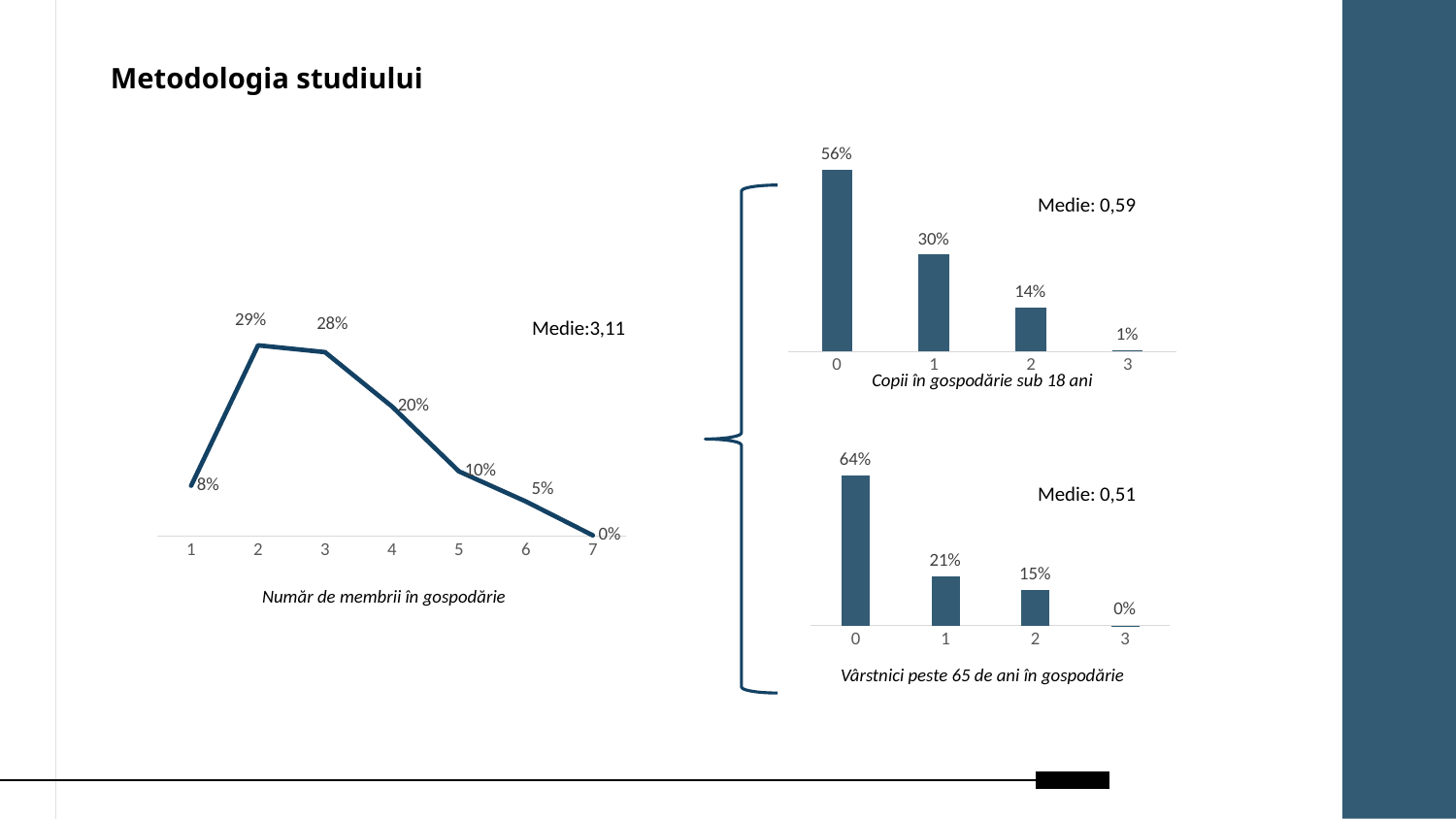
In the chart 'Număr de membrii în gospodărie', what is the value for 5 members? 10% In the chart 'Copii în gospodărie sub 18 ani', which category has the lowest value? 3 In the chart 'Număr de membrii în gospodărie', do the values rise or fall from 3 members to 7 members? Fall In the chart 'Copii în gospodărie sub 18 ani', what is the difference between the values for 1 child and 2 children? 16% In the chart 'Copii în gospodărie sub 18 ani', what is the value for 0 children? 56% In the chart 'Număr de membrii în gospodărie', how many points are plotted on the x axis? 7 In the chart 'Număr de membrii în gospodărie', what is the value for 2 members? 29% What is the mean (Medie) shown for the chart 'Vârstnici peste 65 de ani în gospodărie'? 0,51 What kind of chart is 'Număr de membrii în gospodărie'? Line chart In the chart 'Număr de membrii în gospodărie', which number of members has the highest value? 2 In the chart 'Vârstnici peste 65 de ani în gospodărie', what is the value for 2 elderly persons? 15% Which is larger: the value for 0 in 'Vârstnici peste 65 de ani în gospodărie' or the value for 0 in 'Copii în gospodărie sub 18 ani'? Vârstnici peste 65 de ani în gospodărie (64%)